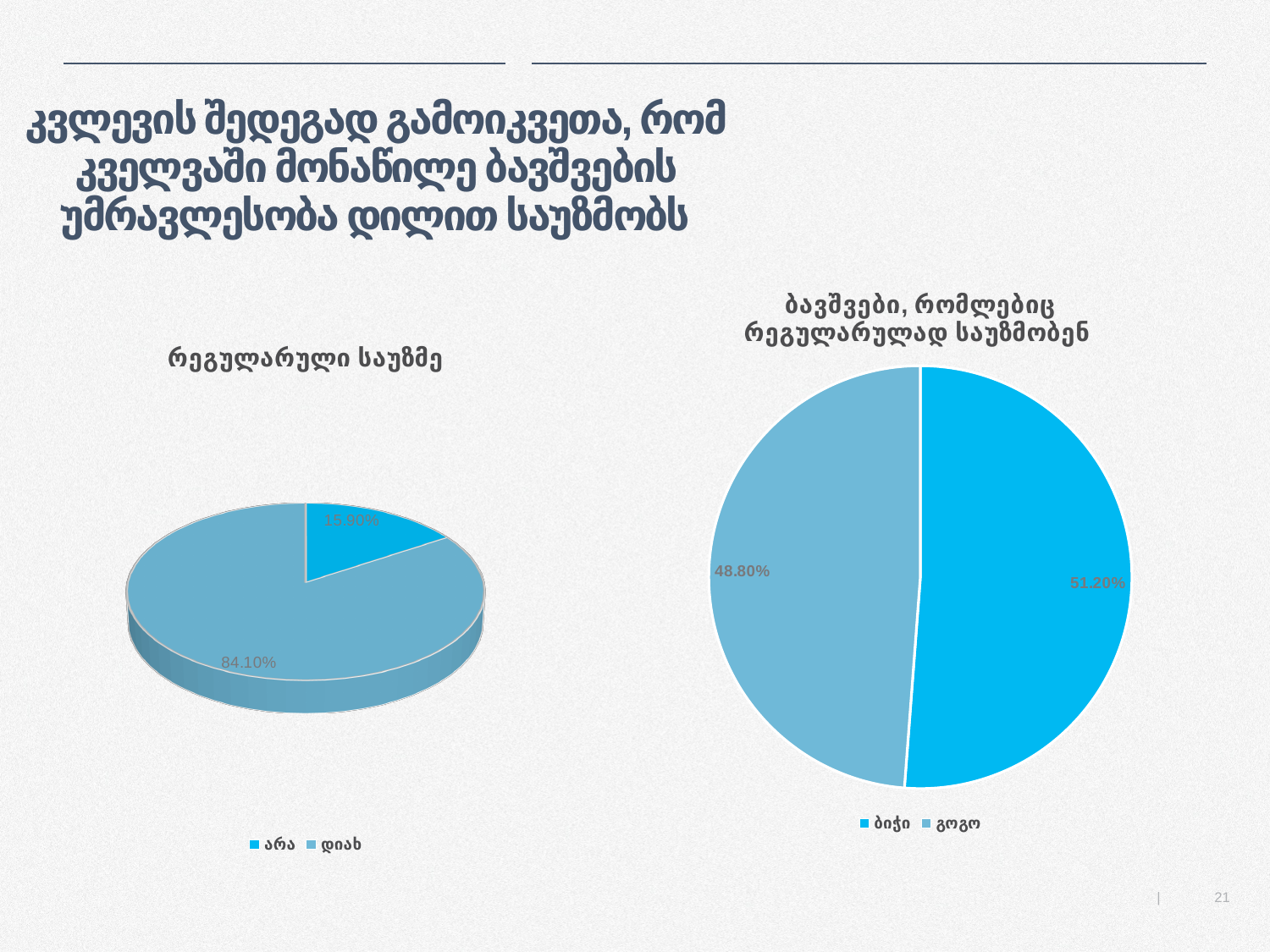
In the left chart titled "რეგულარული საუზმე", what is the value for "დიახ"? 84.10% In the left chart titled "რეგულარული საუზმე", which category has the largest slice? დიახ In the right chart titled "ბავშვები, რომლებიც რეგულარულად საუზმობენ", what is the value for "ბიჭი"? 51.20% What kind of chart is the left chart titled "რეგულარული საუზმე"? Pie chart In the right chart titled "ბავშვები, რომლებიც რეგულარულად საუზმობენ", which slice is larger, "ბიჭი" or "გოგო"? ბიჭი In the right chart titled "ბავშვები, რომლებიც რეგულარულად საუზმობენ", what is the value for "გოგო"? 48.80% In the right chart titled "ბავშვები, რომლებიც რეგულარულად საუზმობენ", what is the difference between the "ბიჭი" and "გოგო" slices? 2.40% In the left chart titled "რეგულარული საუზმე", what is the value for "არა"? 15.90% How many categories does the legend of the right chart titled "ბავშვები, რომლებიც რეგულარულად საუზმობენ" list? 2 What is the title of the left chart on the slide? რეგულარული საუზმე In the left chart titled "რეგულარული საუზმე", what is the difference between the "დიახ" and "არა" slices? 68.20% How many categories does the legend of the left chart titled "რეგულარული საუზმე" list? 2